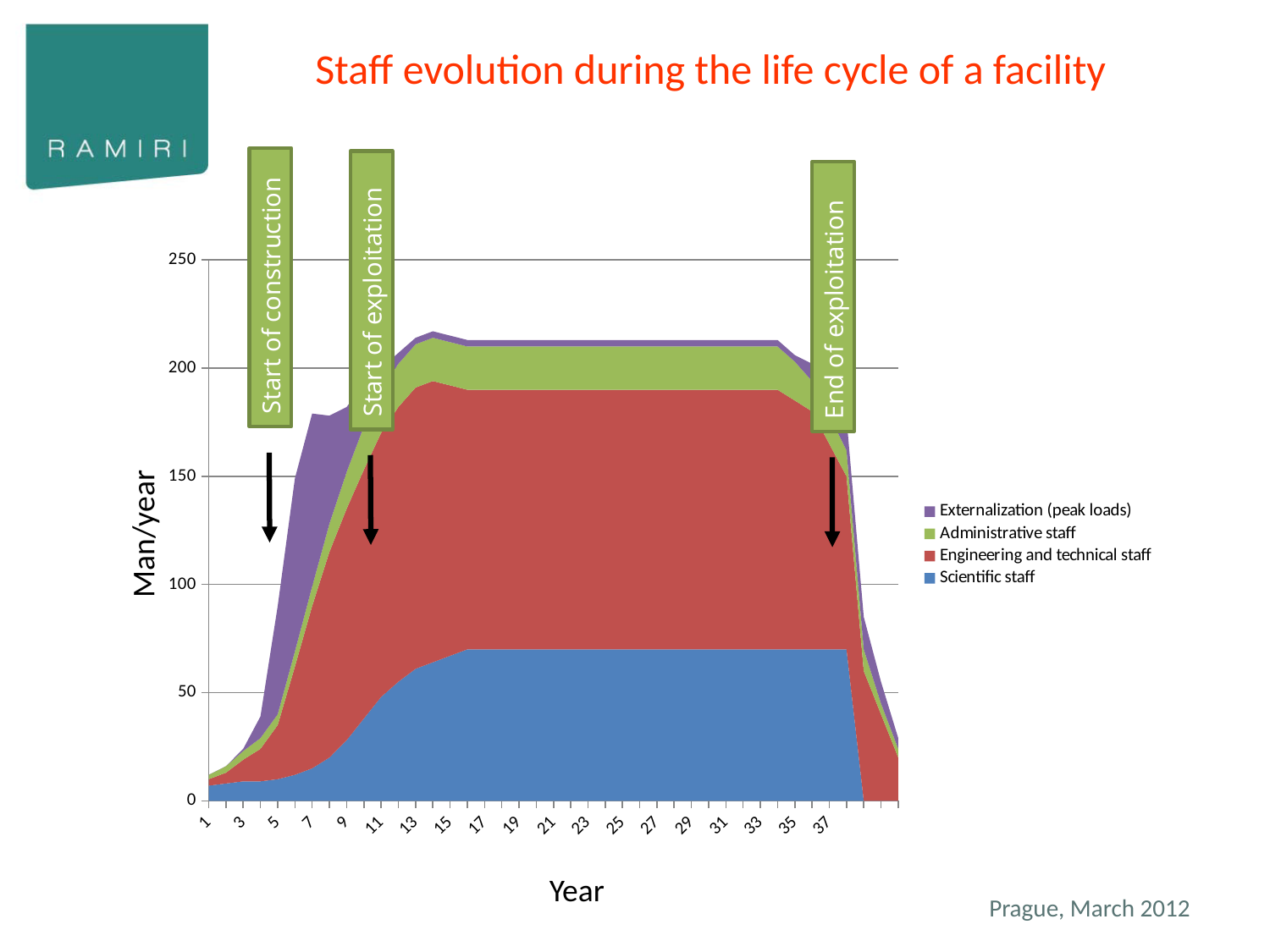
What kind of chart is shown on the slide? Stacked area chart How many series does the legend list? 4 What is the title of the chart? Staff evolution during the life cycle of a facility Does the Scientific staff value rise or fall between year 1 and year 17? rise Is the total staff (top of the stack) at year 13 greater or less than 200? greater Is the Scientific staff value at year 21 greater or less than 50? greater Is the total staff (top of the stack) at year 33 greater or less than 200? greater Does the total staff (top of the stack) rise or fall between year 37 and the end of the x axis? fall Which series is plotted as the bottom (blue) layer of the stacked area? Scientific staff